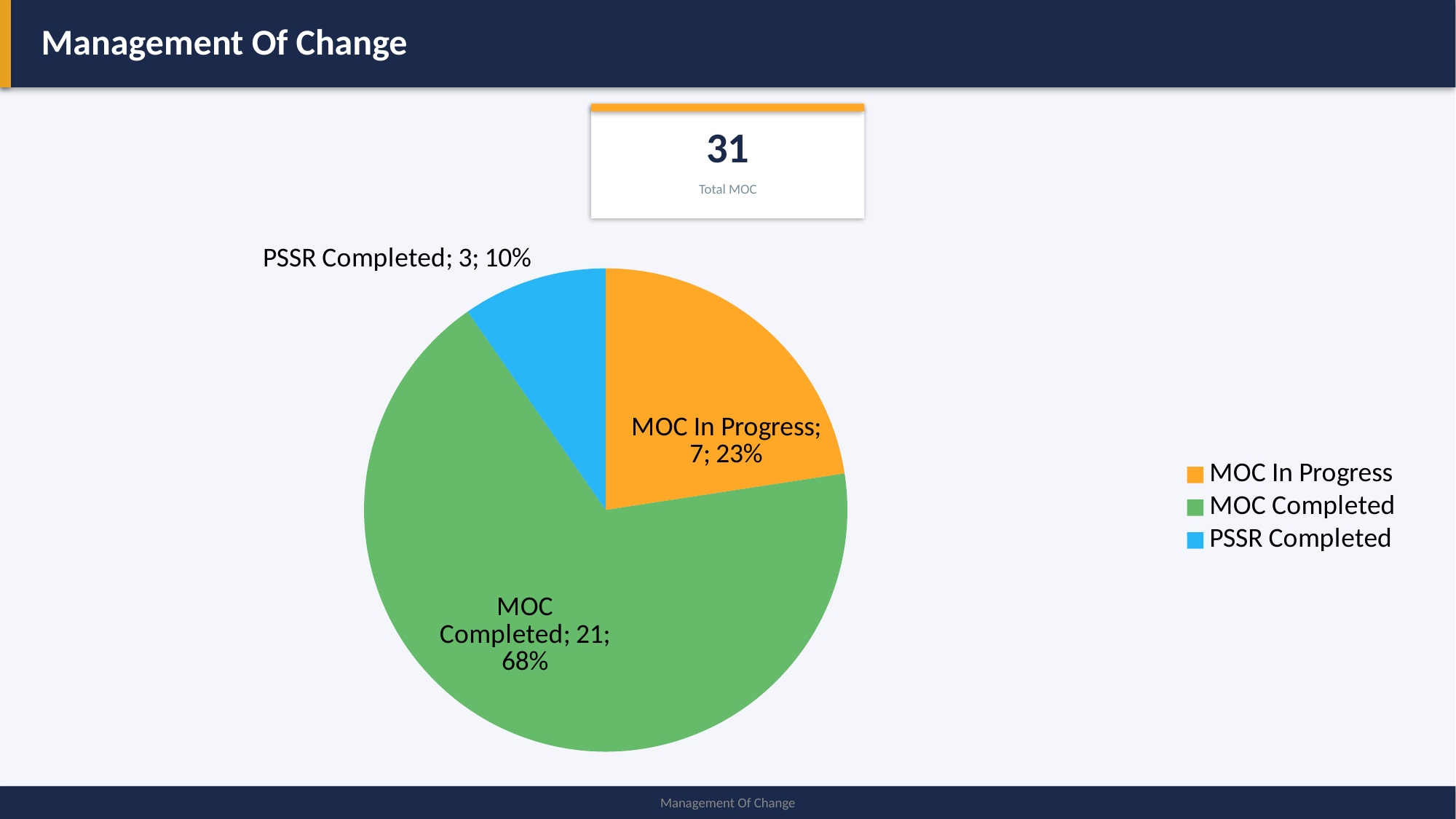
How many entries does the legend list? 3 Which category has the largest slice? MOC Completed What share of the pie does MOC Completed represent? 68% What kind of chart is shown on the slide? pie chart What colour is the MOC In Progress slice? orange How many slices does the pie chart have? 3 What is the value for MOC In Progress? 7 What is the value for PSSR Completed? 3 What is the difference between the values for MOC Completed and MOC In Progress? 14 What share of the pie does PSSR Completed represent? 10% Which category has the smallest slice? PSSR Completed What is the value for MOC Completed? 21